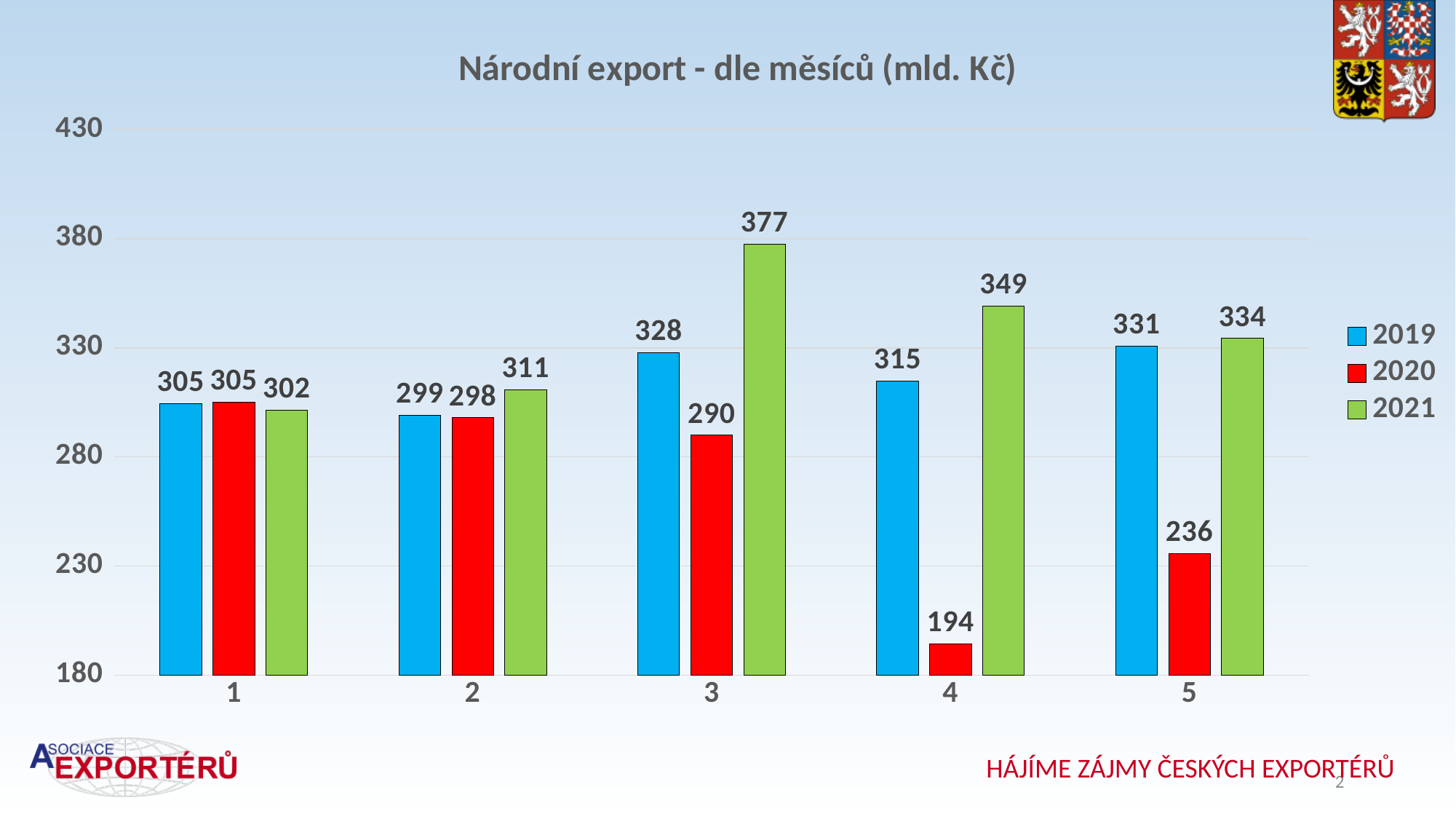
What is the value for 2021 in month 3? 377 Which month has the highest value for the 2021 series? 3 How many series does the legend list? 3 How many months are shown on the x axis? 5 Which is larger in month 4: the 2019 value or the 2021 value? 2021 What is the title of the chart? Národní export - dle měsíců (mld. Kč) What is the value for 2020 in month 4? 194 What kind of chart is shown on the slide? bar chart What is the difference between the 2021 and 2020 values in month 5? 98 What is the value for 2019 in month 5? 331 Is the value for 2020 in month 5 greater or less than 280? less Which month has the lowest value for the 2020 series? 4